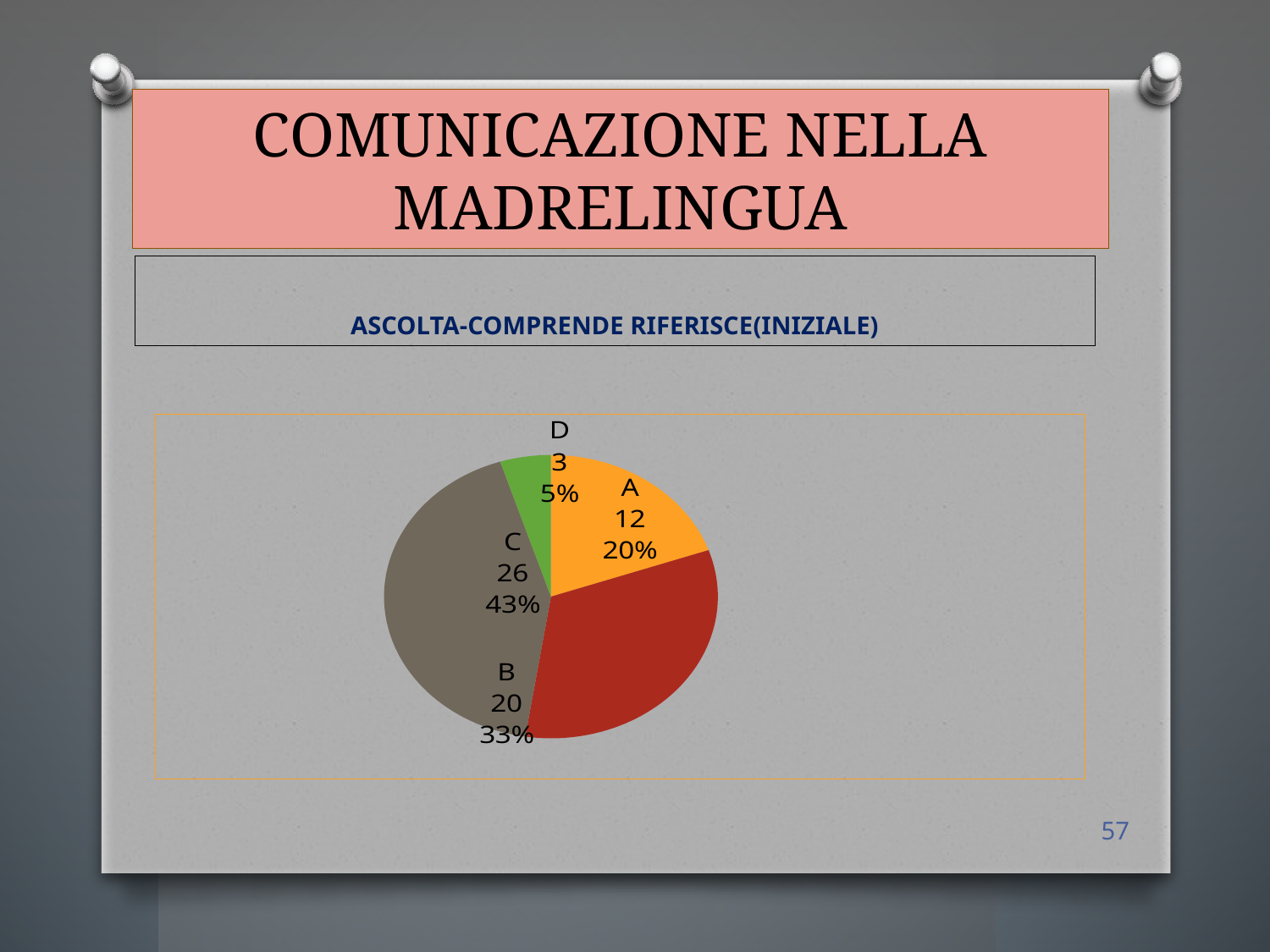
Which category has the smallest slice in the pie chart? D What is the value for category D in the pie chart? 3 What is the difference between the values for C and B in the pie chart? 6 What is the total of all the values shown in the pie chart? 61 What is the value for category A in the pie chart? 12 How many slices does the pie chart have? 4 Which is larger in the pie chart, the value for A or the value for B? B Which category has the largest slice in the pie chart? C What is the title shown above the pie chart? ASCOLTA-COMPRENDE RIFERISCE(INIZIALE) What type of chart is shown on the slide? pie chart What percentage share does category B have in the pie chart? 33% What percentage share does category C have in the pie chart? 43%